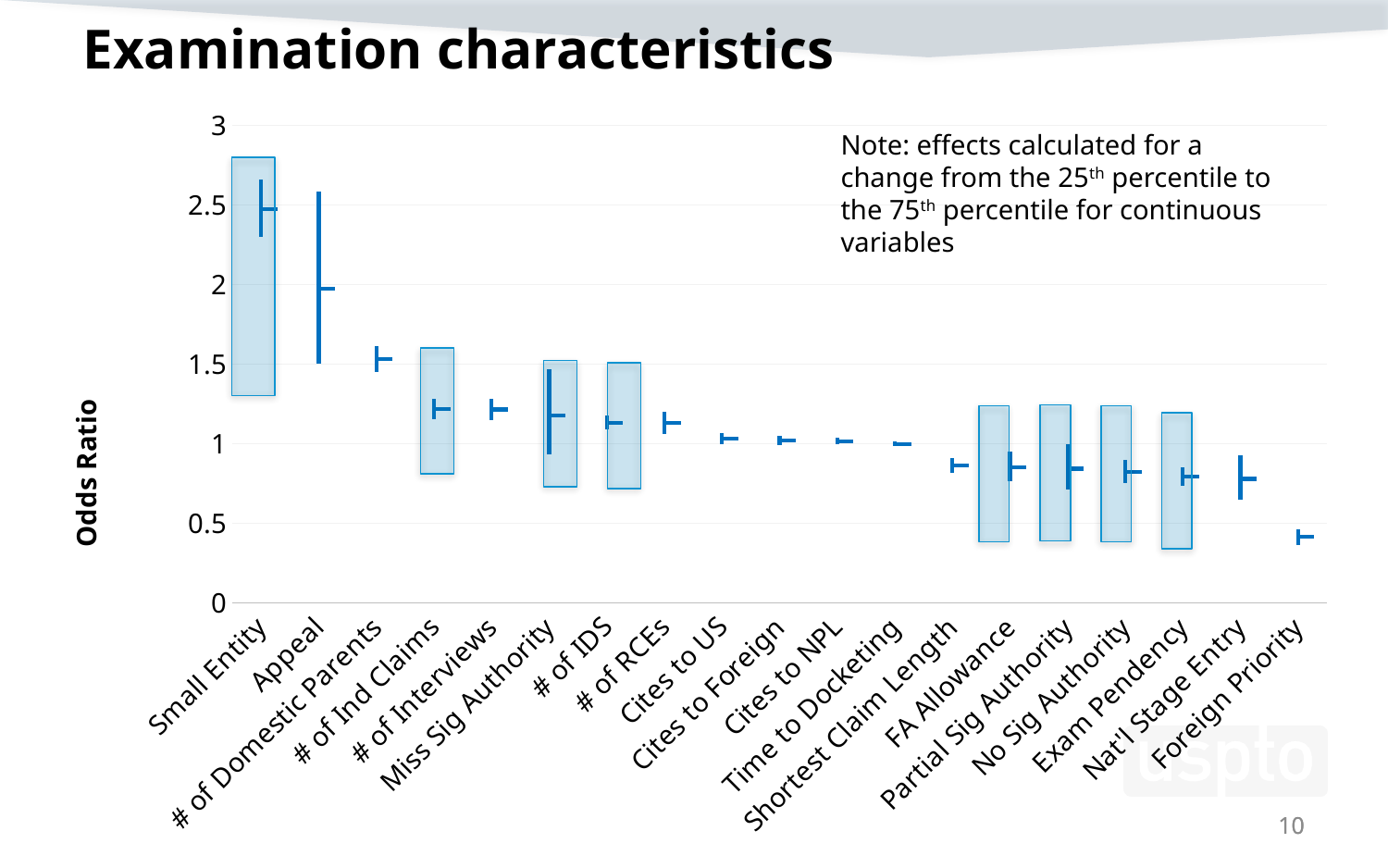
Is the odds ratio for Small Entity greater or less than 2? greater Is the odds ratio for Foreign Priority greater or less than 0.5? less Is the odds ratio for Exam Pendency greater or less than 1? less What is the maximum value shown on the vertical axis? 3 What is the label of the vertical axis? Odds Ratio Which category has the lowest odds ratio? Foreign Priority Which category has the highest odds ratio? Small Entity Which has a larger odds ratio, # of Ind Claims or Exam Pendency? # of Ind Claims Do the odds ratios generally rise or fall moving from left to right along the horizontal axis? fall How many categories are shown along the horizontal axis? 19